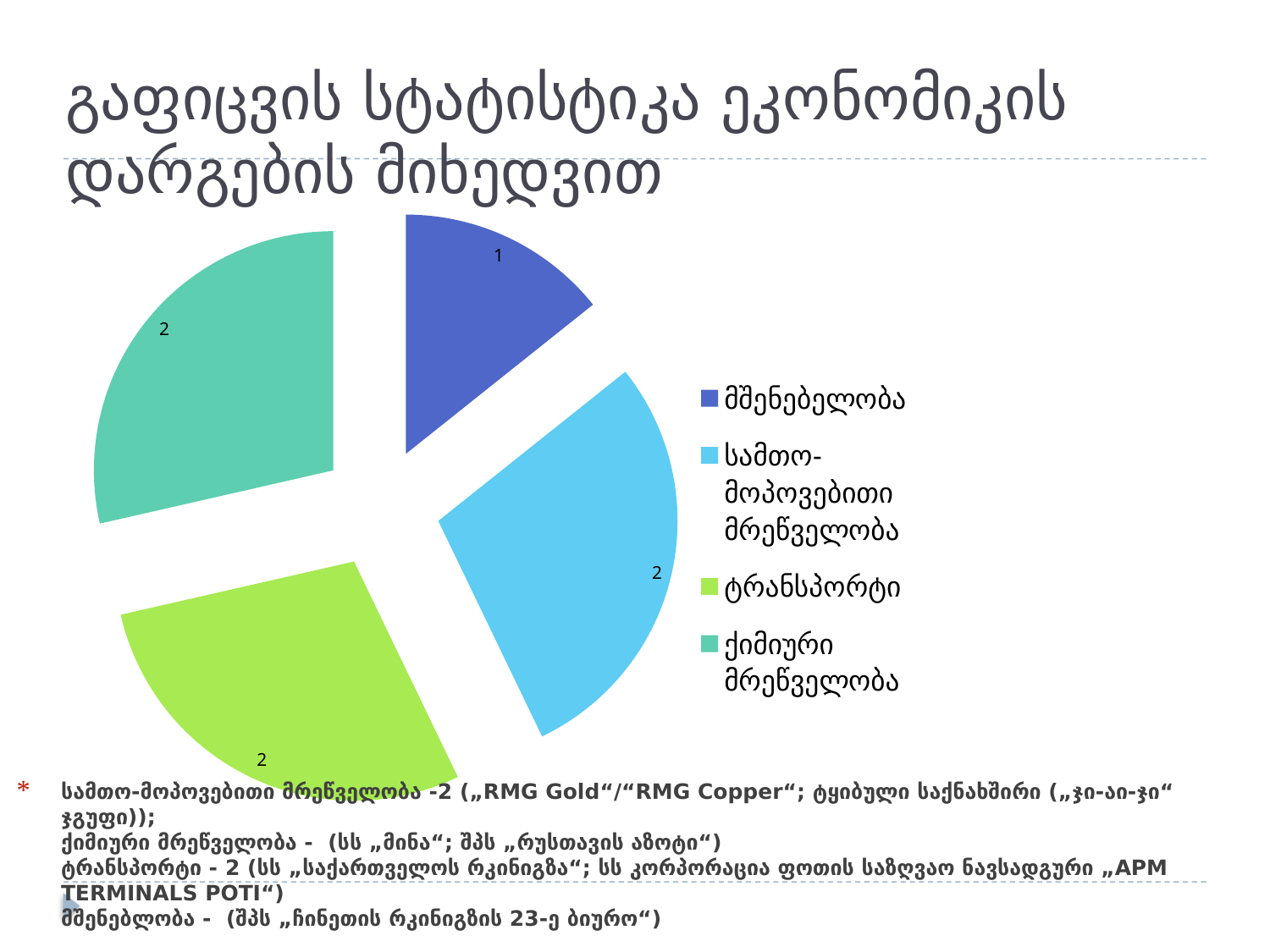
What is the difference between the value for ქიმიური მრეწველობა and the value for მშენებლობა? 1 What is the value for ტრანსპორტი? 2 What is the value for ქიმიური მრეწველობა? 2 Which category has the smallest slice of the pie? მშენებლობა What kind of chart is shown on the slide? pie chart What is the value for სამთო-მოპოვებითი მრეწველობა? 2 Which is larger, the value for ტრანსპორტი or the value for მშენებლობა? ტრანსპორტი What is the value for მშენებლობა? 1 How many slices does the pie chart have? 4 What colour is the slice for მშენებლობა? dark blue How many entries does the legend list? 4 What is the total of all the values shown in the pie chart? 7